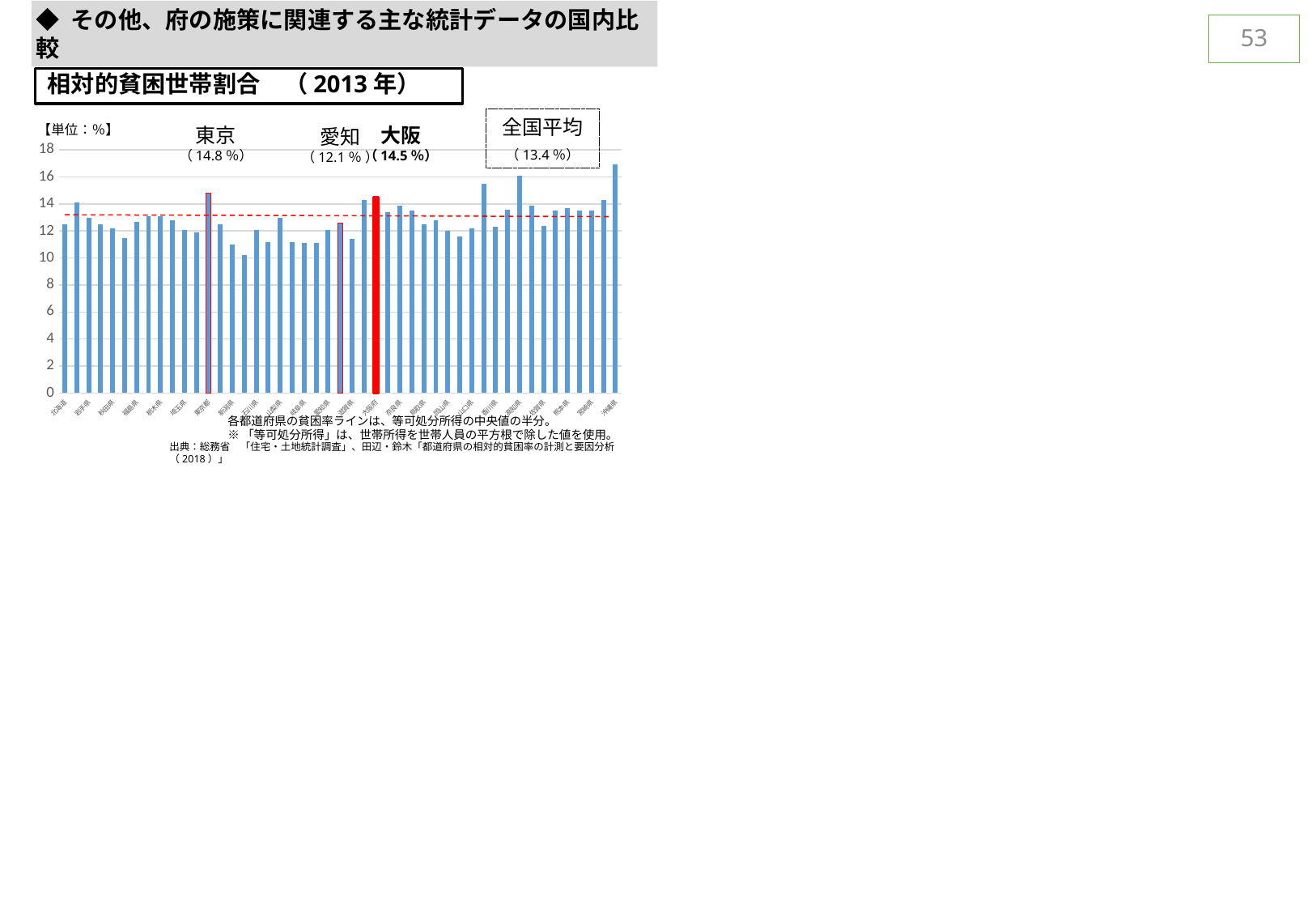
What is the title of the chart? 相対的貧困世帯割合（2013年） Is the value for the rightmost bar (沖縄県) greater or less than 16? greater What kind of chart is shown on the slide? Bar chart What is the difference between Osaka's value and Aichi's value? 2.4 What is the relative poverty household rate shown for 大阪 (Osaka)? 14.5% By how many percentage points does Tokyo's value exceed Osaka's? 0.3 What is the national average (全国平均) value shown on the chart? 13.4% Which has the higher relative poverty household rate, Tokyo or Osaka? Tokyo What does the red dashed horizontal line on the chart represent? 全国平均 (13.4%) Is Osaka's value above or below the national average? Above What is the relative poverty household rate shown for 東京 (Tokyo)? 14.8% What is the relative poverty household rate shown for 愛知 (Aichi)? 12.1%